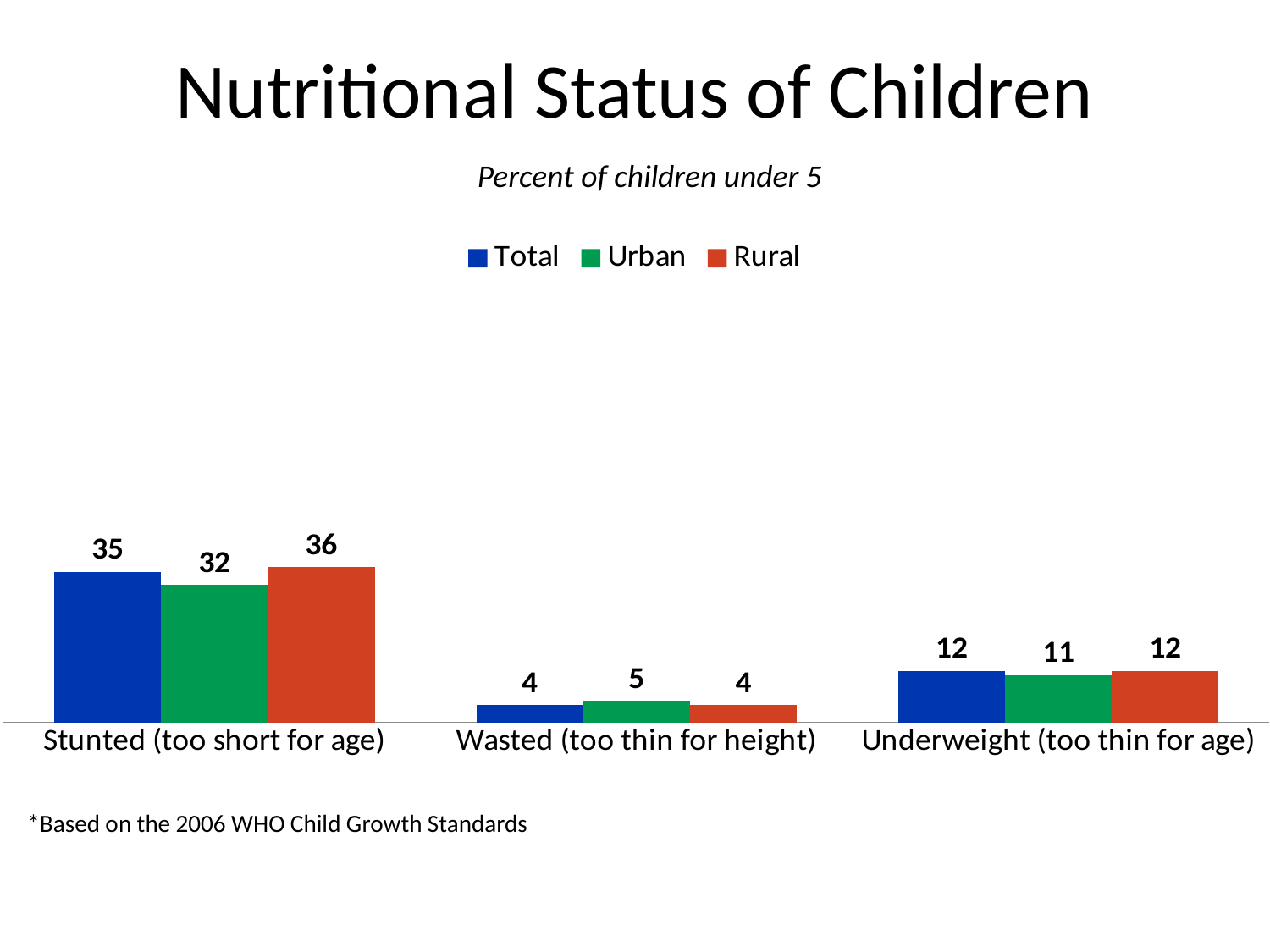
What is the difference between the Rural and Urban values for Stunted (too short for age)? 4 What kind of chart is shown on the slide? Bar chart Which category has the highest Rural value? Stunted (too short for age) What is the Urban value for Wasted (too thin for height)? 5 Which category has the lowest Total value? Wasted (too thin for height) What is the Urban value for Stunted (too short for age)? 32 Which is larger for Underweight (too thin for age): the Total value or the Urban value? Total How many categories are shown on the x axis? 3 What is the Total value for Stunted (too short for age)? 35 What is the Rural value for Underweight (too thin for age)? 12 How many series does the legend list? 3 What is the subtitle shown below the chart title? Percent of children under 5